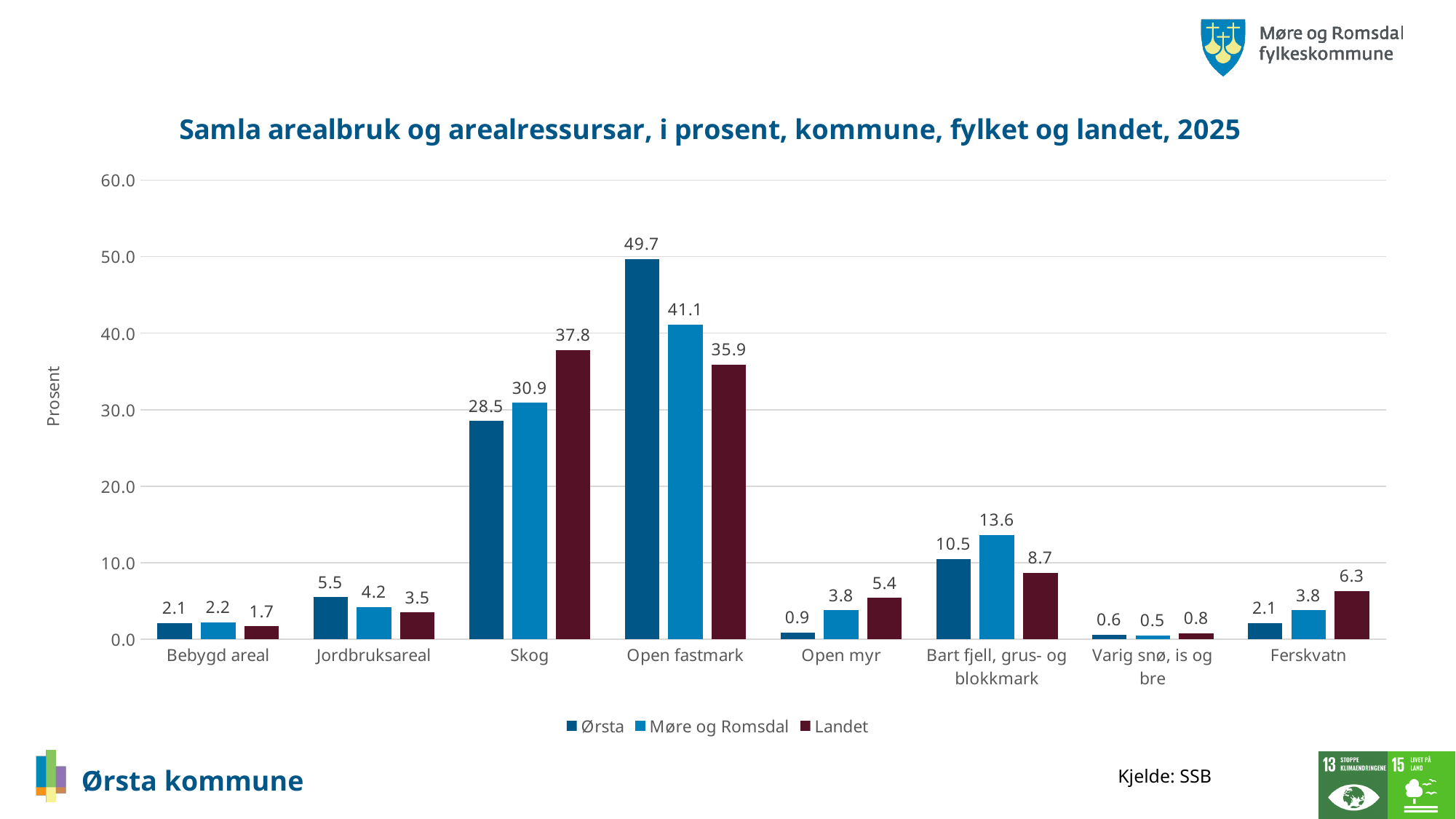
What is the value for Ørsta in the Skog category? 28.5 What is the value for Landet in the Open fastmark category? 35.9 What is the label of the y axis? Prosent How many categories are shown on the x axis? 8 What is the difference between the Ørsta and Landet values for Open fastmark? 13.8 Which category has the highest value for Ørsta? Open fastmark How many series does the legend list? 3 What is the value for Møre og Romsdal in the Bart fjell, grus- og blokkmark category? 13.6 What kind of chart is shown on the slide? Bar chart Which is larger in the Skog category: the value for Ørsta or the value for Landet? Landet Which category has the lowest value for Møre og Romsdal? Varig snø, is og bre Is the value for Møre og Romsdal in the Open fastmark category greater or less than 40.0? greater